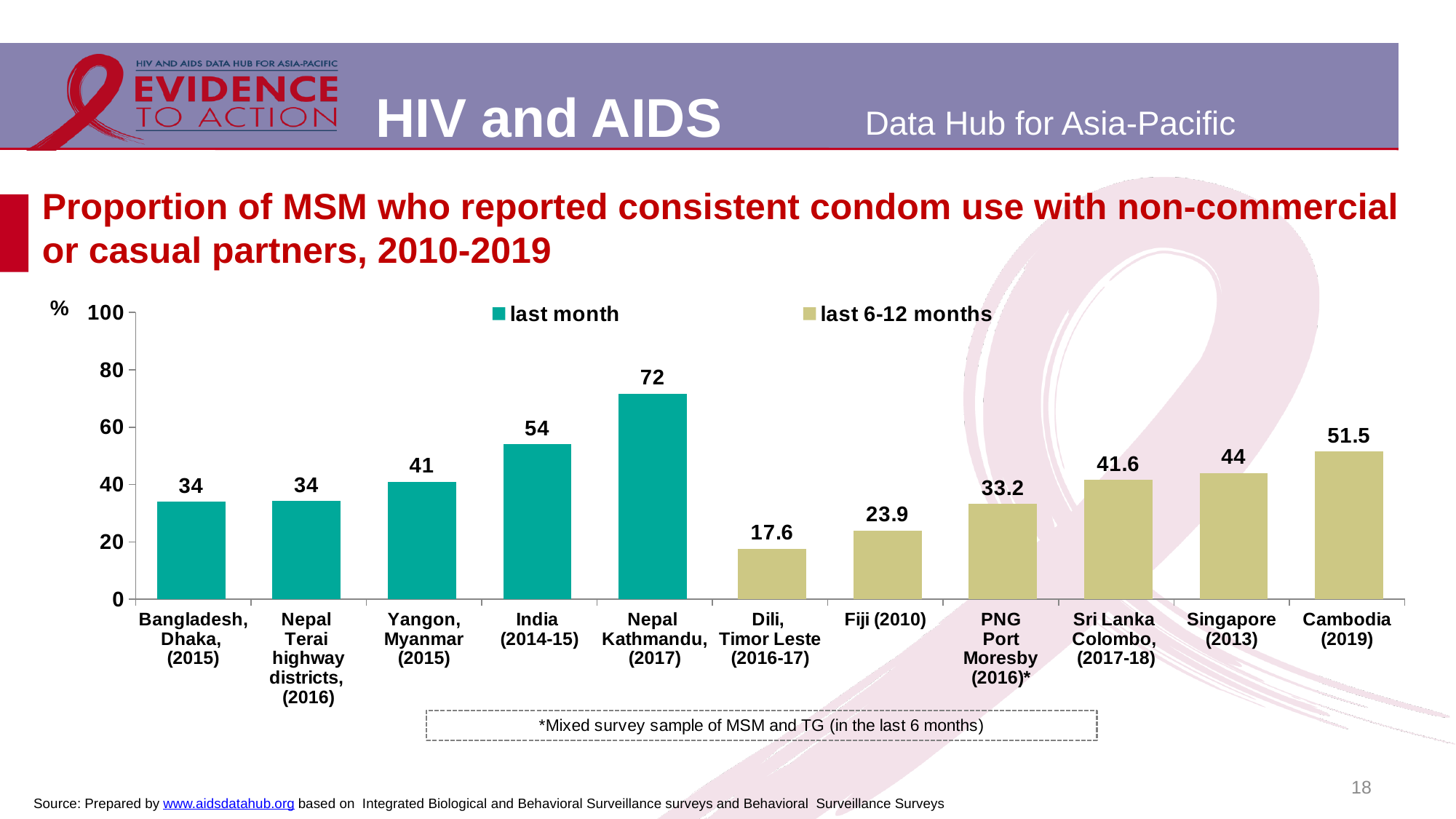
Which is larger, the value for Singapore (2013) or Sri Lanka Colombo (2017-18)? Singapore (2013) What is the value for Dili, Timor Leste (2016-17)? 17.6 What is the value for Cambodia (2019)? 51.5 How many categories are shown on the x axis? 11 What is the value for Nepal Kathmandu (2017)? 72 What kind of chart is shown? bar chart Which category has the highest value? Nepal Kathmandu (2017) Is the value for PNG Port Moresby (2016) greater or less than 40? less What is the difference between the values for India (2014-15) and Fiji (2010)? 30.1 Which category has the lowest value? Dili, Timor Leste (2016-17) How many series does the legend list? 2 Which series does the Yangon, Myanmar (2015) bar belong to? last month